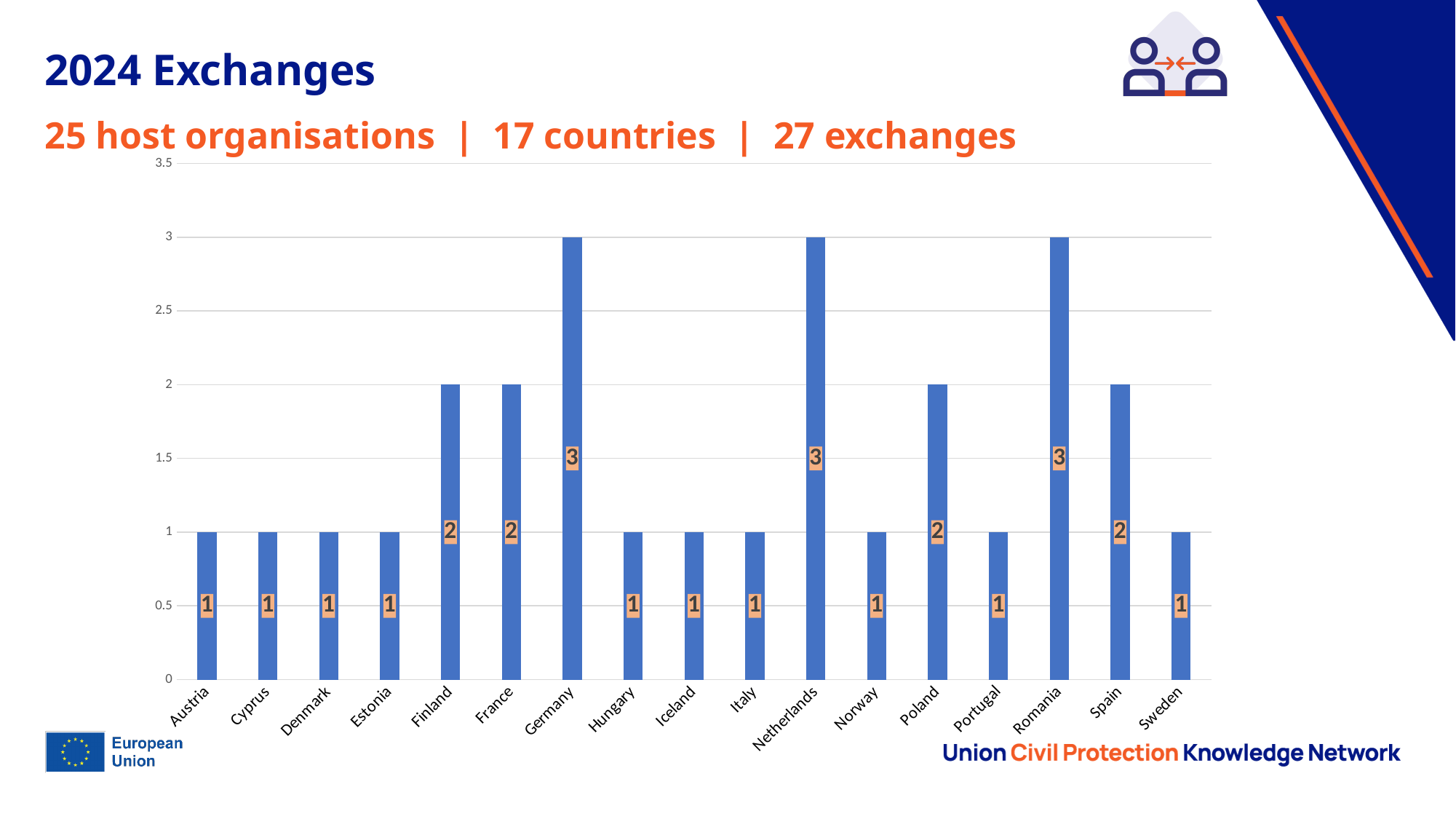
What is the value for Finland? 2 What type of chart is shown on the slide? bar chart How many countries are shown on the x axis of the chart? 17 How many countries have a value of 2? 4 What is the title of the slide containing the chart? 2024 Exchanges What is the value for Sweden? 1 Which is larger, the value for Poland or the value for Portugal? Poland What is the sum of all the bar values in the chart? 27 What is the value for Netherlands? 3 Which countries have the highest value in the chart? Germany, Netherlands, Romania What is the value for Germany? 3 What is the difference between the value for Romania and the value for Spain? 1